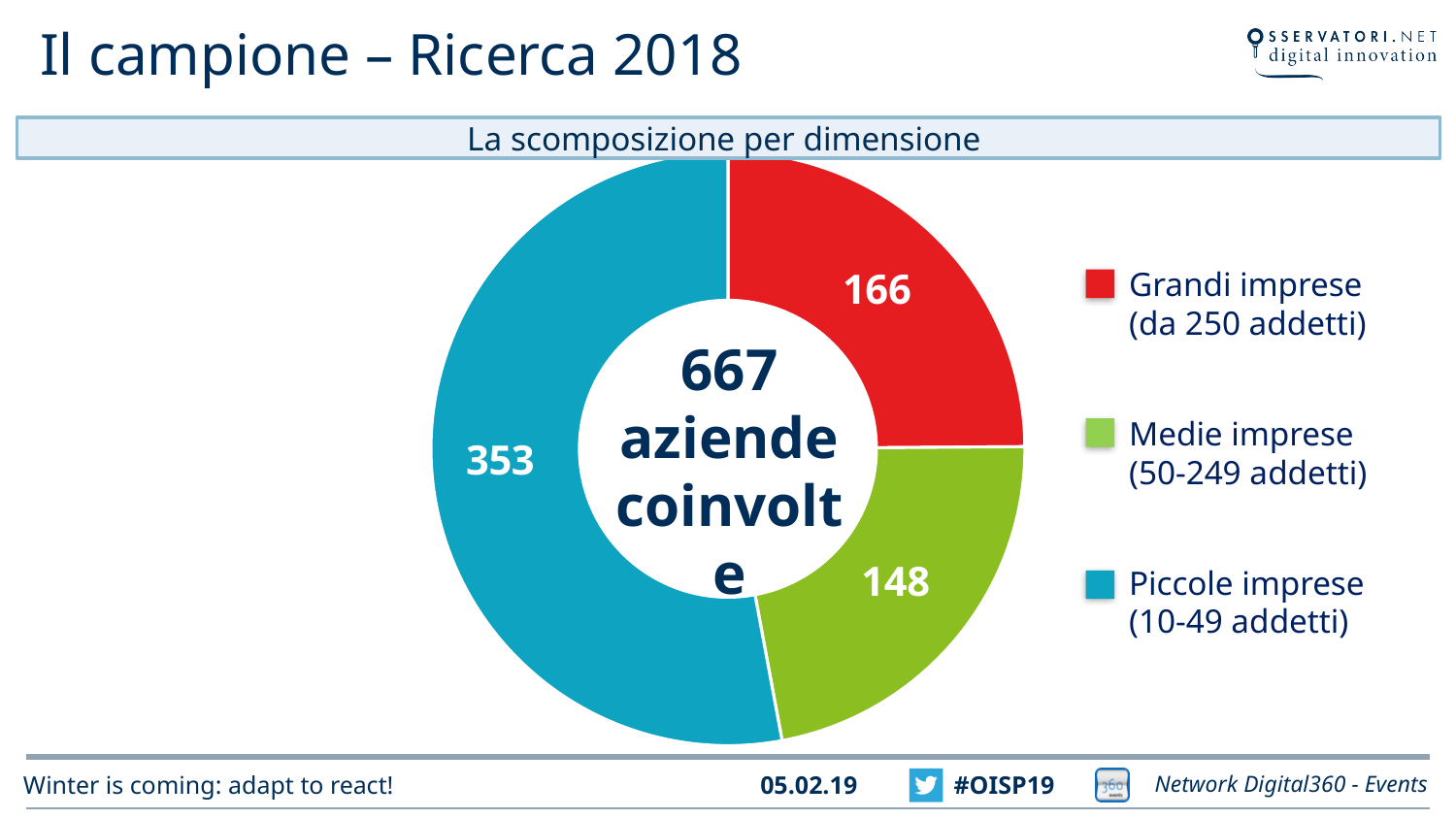
How many companies are in the Grandi imprese (da 250 addetti) segment? 166 What total number of companies is shown in the centre of the chart? 667 What is the difference between the Grandi imprese and Medie imprese values? 18 How many companies are in the Medie imprese (50-249 addetti) segment? 148 What type of chart is shown on the slide? Donut (pie) chart What is the difference between the Piccole imprese and Grandi imprese values? 187 How many companies are in the Piccole imprese (10-49 addetti) segment? 353 Which is larger, the Grandi imprese segment or the Medie imprese segment? Grandi imprese How many categories does the chart show? 3 Which company size category has the largest segment in the chart? Piccole imprese (10-49 addetti) What colour represents Piccole imprese (10-49 addetti) in the chart? Blue (teal) Which company size category has the smallest segment in the chart? Medie imprese (50-249 addetti)